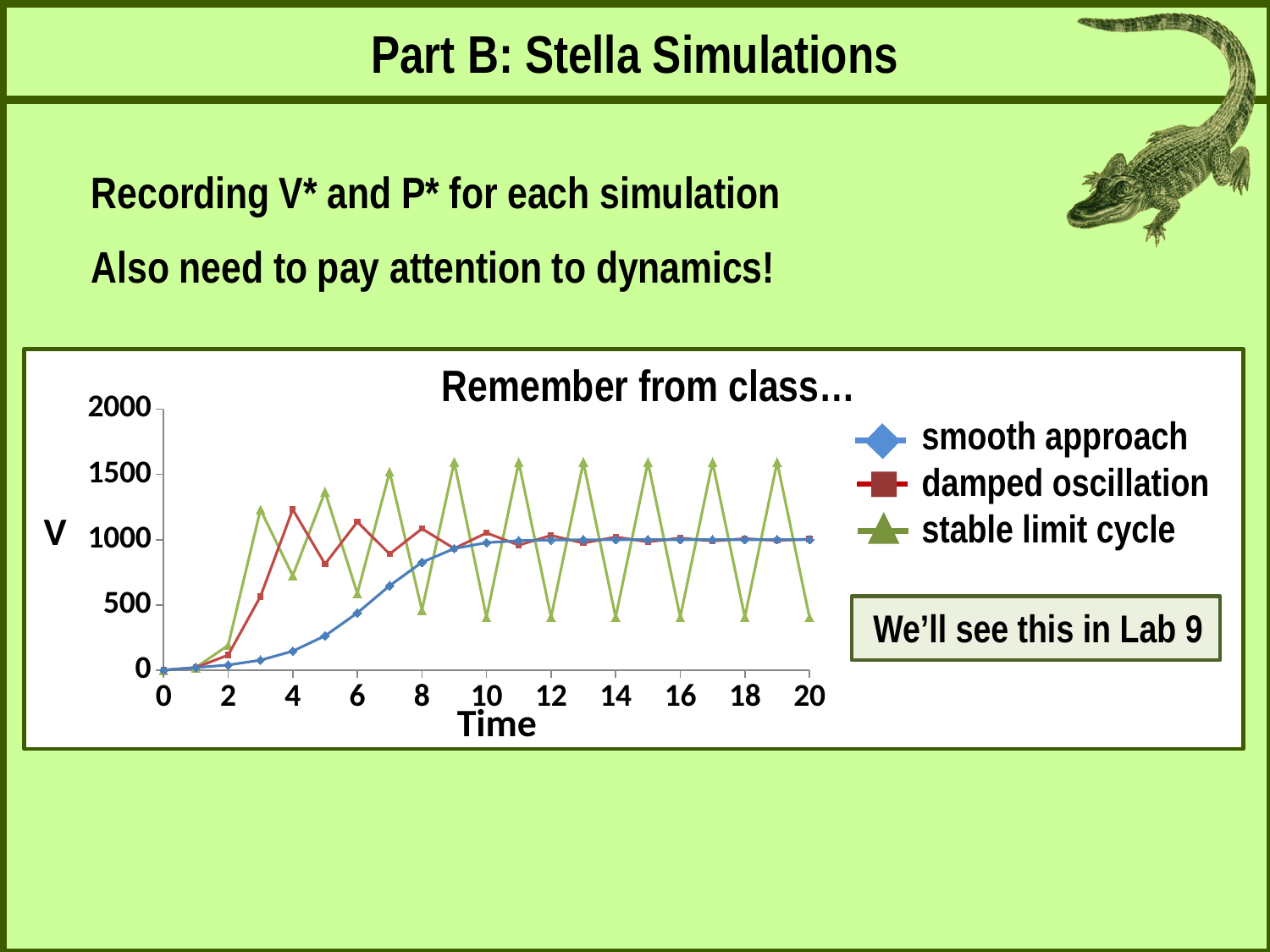
Does the smooth approach series rise or fall as time increases from 0 to 10? rise Is the value of the stable limit cycle series at time 3 greater or less than 1000? greater What is the label of the x axis? Time At time 4, which series has the larger value: damped oscillation or smooth approach? damped oscillation Is the value of the smooth approach series at time 6 greater or less than 500? less What kind of chart is shown on the slide? line chart Is the value of the stable limit cycle series at time 10 greater or less than 500? less How many series does the legend list? 3 At time 10, which series has the larger value: stable limit cycle or smooth approach? smooth approach Which series reaches the highest value on the chart? stable limit cycle What is the title of the chart? Remember from class…